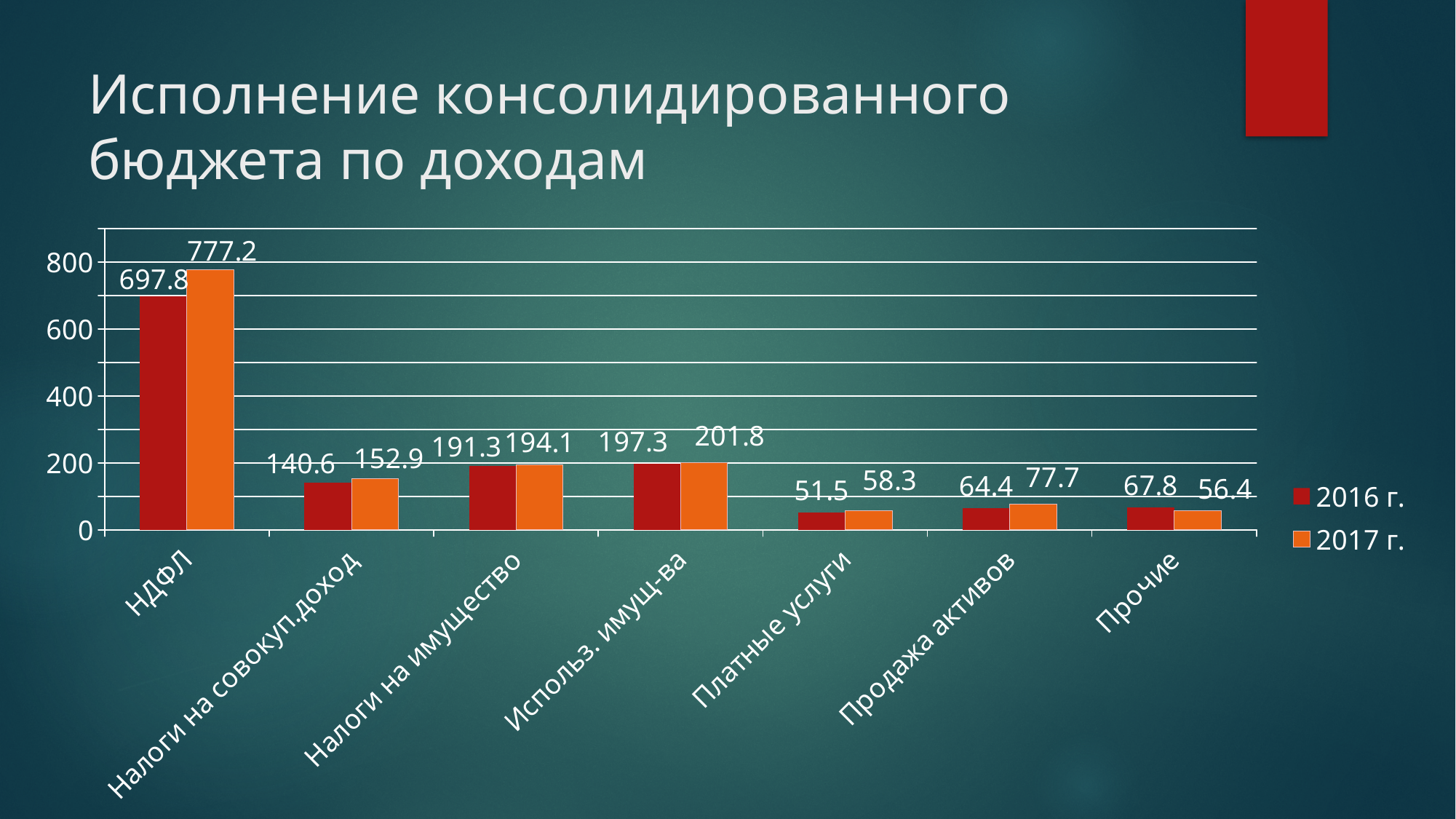
Is the 2016 г. value for Налоги на совокуп.доход greater or less than 200? less What is the value for НДФЛ in the 2017 г. series? 777.2 What kind of chart is shown on the slide? bar chart What is the difference between the 2017 г. and 2016 г. values for НДФЛ? 79.4 What is the value for Платные услуги in the 2016 г. series? 51.5 Which category has the lowest value in the 2017 г. series? Прочие How many categories are shown on the x axis? 7 Which is larger for Прочие: the 2016 г. value or the 2017 г. value? 2016 г. What is the value for Продажа активов in the 2017 г. series? 77.7 Which category has the highest value in the 2016 г. series? НДФЛ How many series does the legend list? 2 What is the title of the slide? Исполнение консолидированного бюджета по доходам